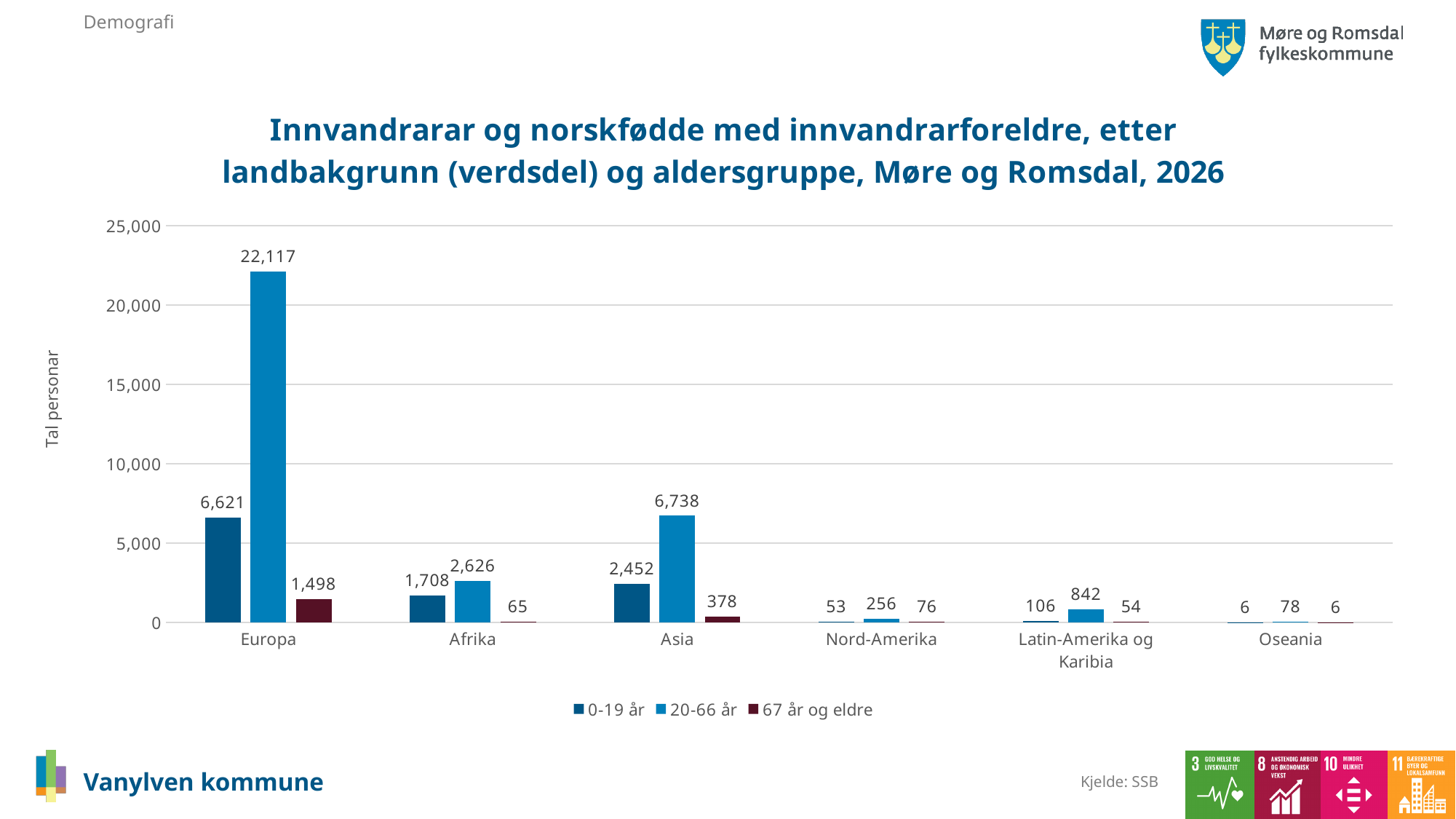
Which category has the highest value in the 20-66 år series? Europa What is the label of the y axis? Tal personar What is the value for the 20-66 år series for Europa? 22,117 Which category has the lowest value in the 0-19 år series? Oseania How many categories are shown on the x axis? 6 Which is larger: the 0-19 år value for Europa or the 20-66 år value for Asia? 20-66 år value for Asia What kind of chart is shown on the slide? Bar chart What is the value for the 67 år og eldre series for Afrika? 65 What is the value for the 0-19 år series for Asia? 2,452 What is the difference between the 20-66 år values for Asia and Afrika? 4,112 How many series does the legend list? 3 What is the value for the 20-66 år series for Latin-Amerika og Karibia? 842